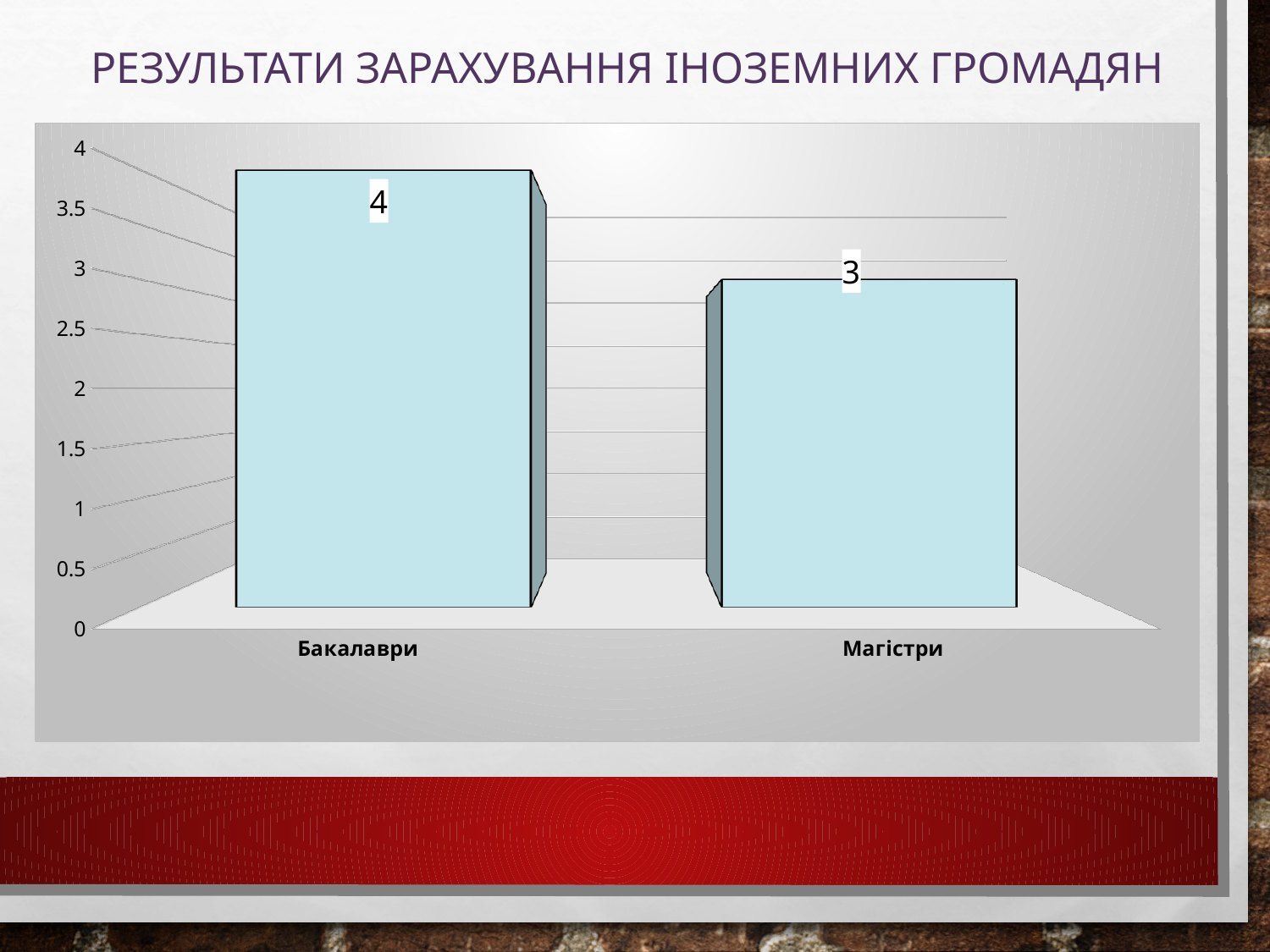
What kind of chart is shown on the slide? bar chart What is the difference between the values for Бакалаври and Магістри? 1 How many categories are shown on the chart? 2 What is the value for Магістри? 3 Is the value for Бакалаври greater or less than 2? greater What is the title of the slide? РЕЗУЛЬТАТИ ЗАРАХУВАННЯ ІНОЗЕМНИХ ГРОМАДЯН Is the value for Магістри greater or less than 3.5? less What is the value for Бакалаври? 4 Which is larger, the value for Бакалаври or the value for Магістри? Бакалаври Which category has the lowest value? Магістри What is the maximum value shown on the vertical axis? 4 Which category has the highest value? Бакалаври